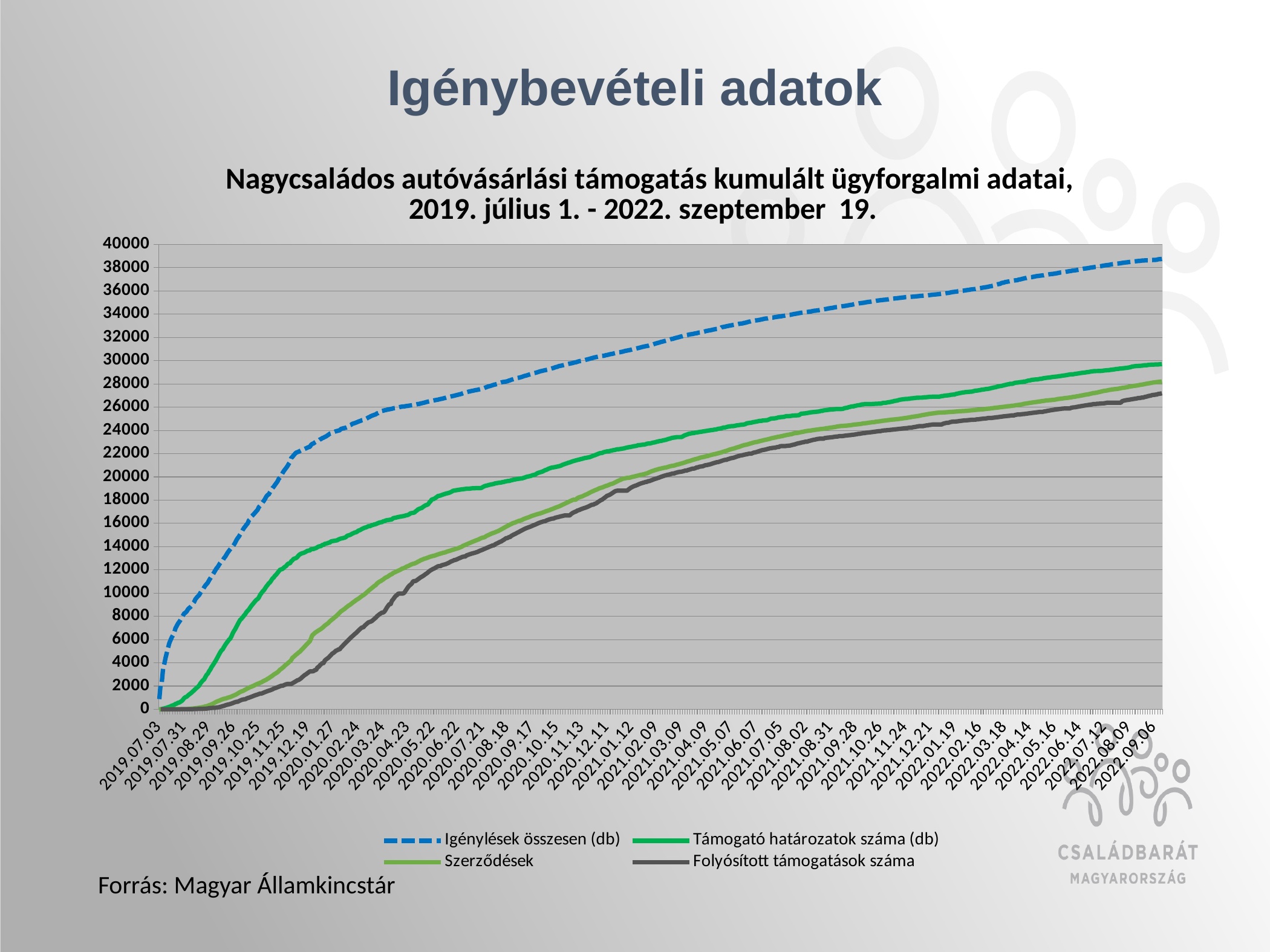
What kind of chart is shown on the slide? line chart How many series does the legend list? 4 Which series has the highest value at the last date, 2022.09.06? Igénylések összesen (db) At 2020.08.18, which is larger: Igénylések összesen (db) or Támogató határozatok száma (db)? Igénylések összesen (db) Is the value for Támogató határozatok száma (db) at 2019.12.19 greater or less than 12000? greater Which series is drawn with a dashed line? Igénylések összesen (db) Is the value for Igénylések összesen (db) at 2022.09.06 greater or less than 36000? greater Is the value for Folyósított támogatások száma at 2022.09.06 greater or less than 26000? greater What is the title of the chart? Nagycsaládos autóvásárlási támogatás kumulált ügyforgalmi adatai, 2019. július 1. - 2022. szeptember 19. Do the values of the Igénylések összesen (db) series rise or fall along the x axis? rise Which series has the lowest value at the last date, 2022.09.06? Folyósított támogatások száma